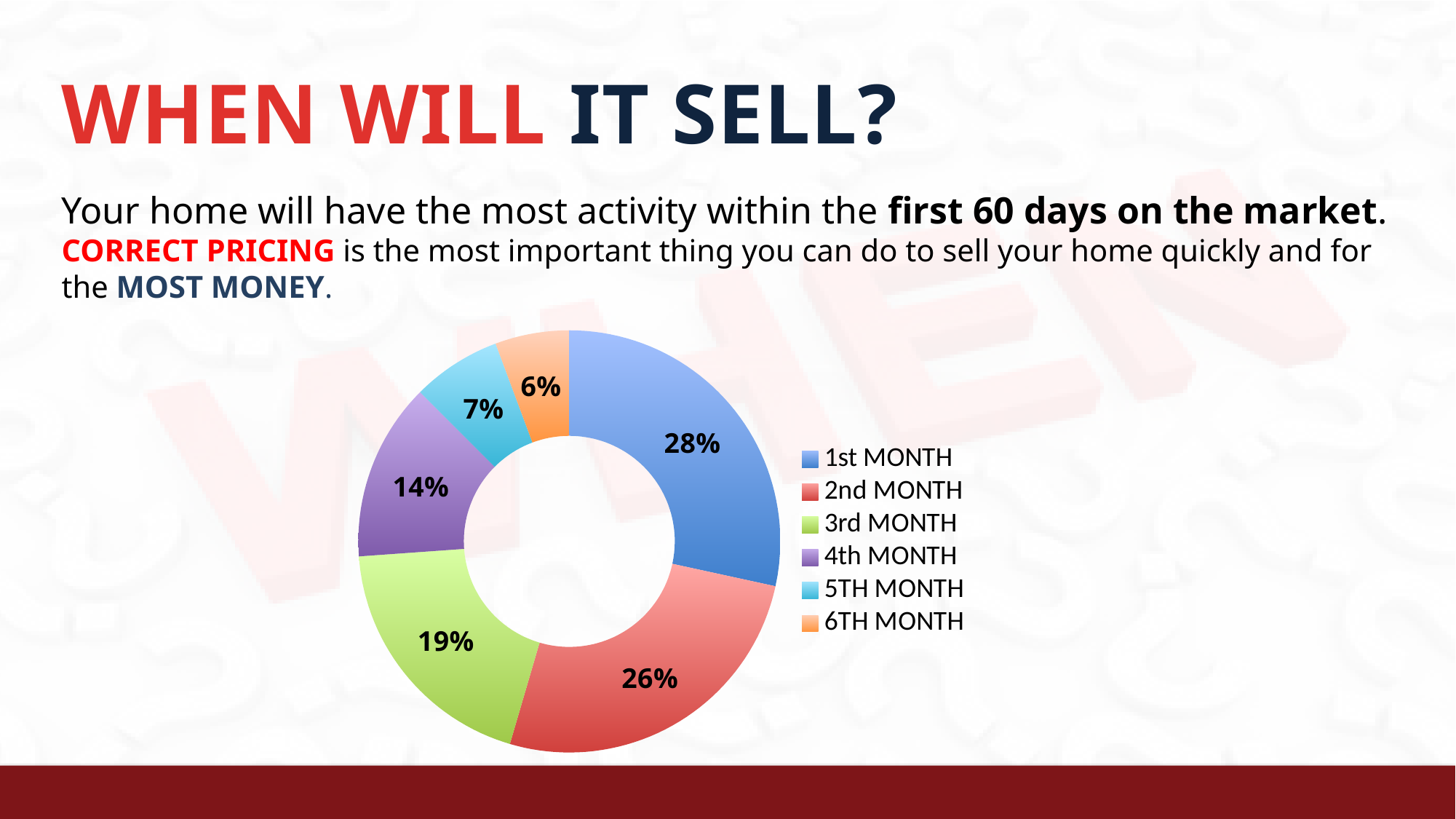
What is the difference between the 1st MONTH and 2nd MONTH values? 2% What kind of chart is shown on the slide? Doughnut chart What is the value shown for 2nd MONTH? 26% How many categories does the chart show? 6 What is the value shown for 6TH MONTH? 6% Which is larger, the value for 3rd MONTH or 4th MONTH? 3rd MONTH What colour is the slice for 5TH MONTH? Light blue What is the value shown for 4th MONTH? 14% Which month has the largest slice? 1st MONTH What share of the chart does 1st MONTH represent? 28% What is the value shown for 3rd MONTH? 19% Which month has the smallest slice? 6TH MONTH